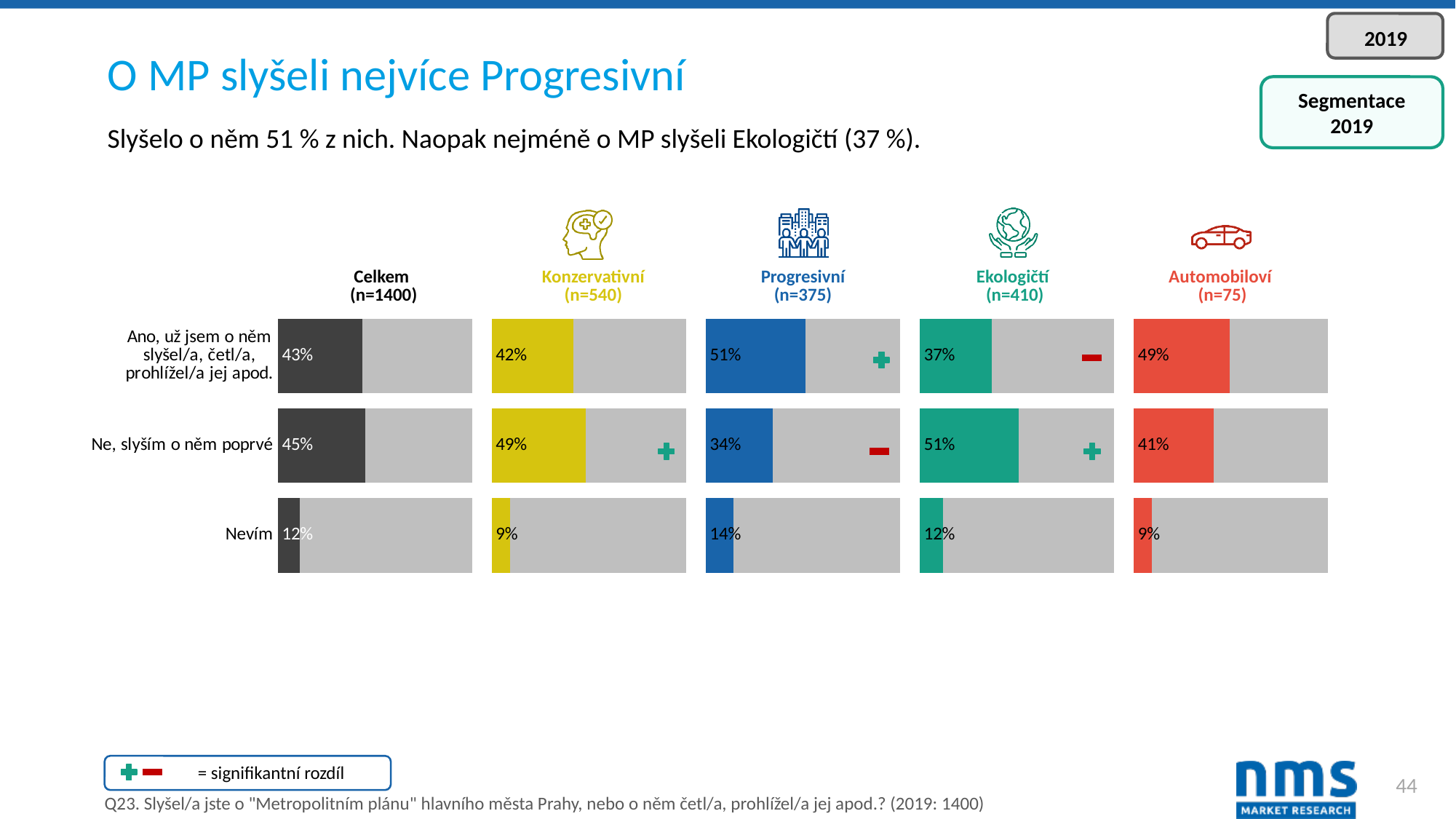
In the Konzervativní chart, which category has the lowest value? Nevím What type of chart is used to show the results on this slide? Bar chart Which is larger: the "Ne, slyším o něm poprvé" value for Konzervativní or for Progresivní? Konzervativní In the Celkem (n=1400) chart, what is the value for "Ne, slyším o něm poprvé"? 45% In the Automobiloví chart, what is the value for "Nevím"? 9% Across the five segment charts, which segment has the lowest value for "Ano, už jsem o něm slyšel/a, četl/a, prohlížel/a jej apod."? Ekologičtí In the Ekologičtí chart, what is the difference between "Ne, slyším o něm poprvé" and "Nevím"? 39 percentage points How many response categories are shown in each chart? 3 In the Ekologičtí chart, what is the value for "Ano, už jsem o něm slyšel/a, četl/a, prohlížel/a jej apod."? 37% In the Progresivní chart, what is the value for "Ano, už jsem o něm slyšel/a, četl/a, prohlížel/a jej apod."? 51% Across the five segment charts, which segment has the highest value for "Ano, už jsem o něm slyšel/a, četl/a, prohlížel/a jej apod."? Progresivní What is the difference between the Progresivní and Ekologičtí values for "Ano, už jsem o něm slyšel/a, četl/a, prohlížel/a jej apod."? 14 percentage points